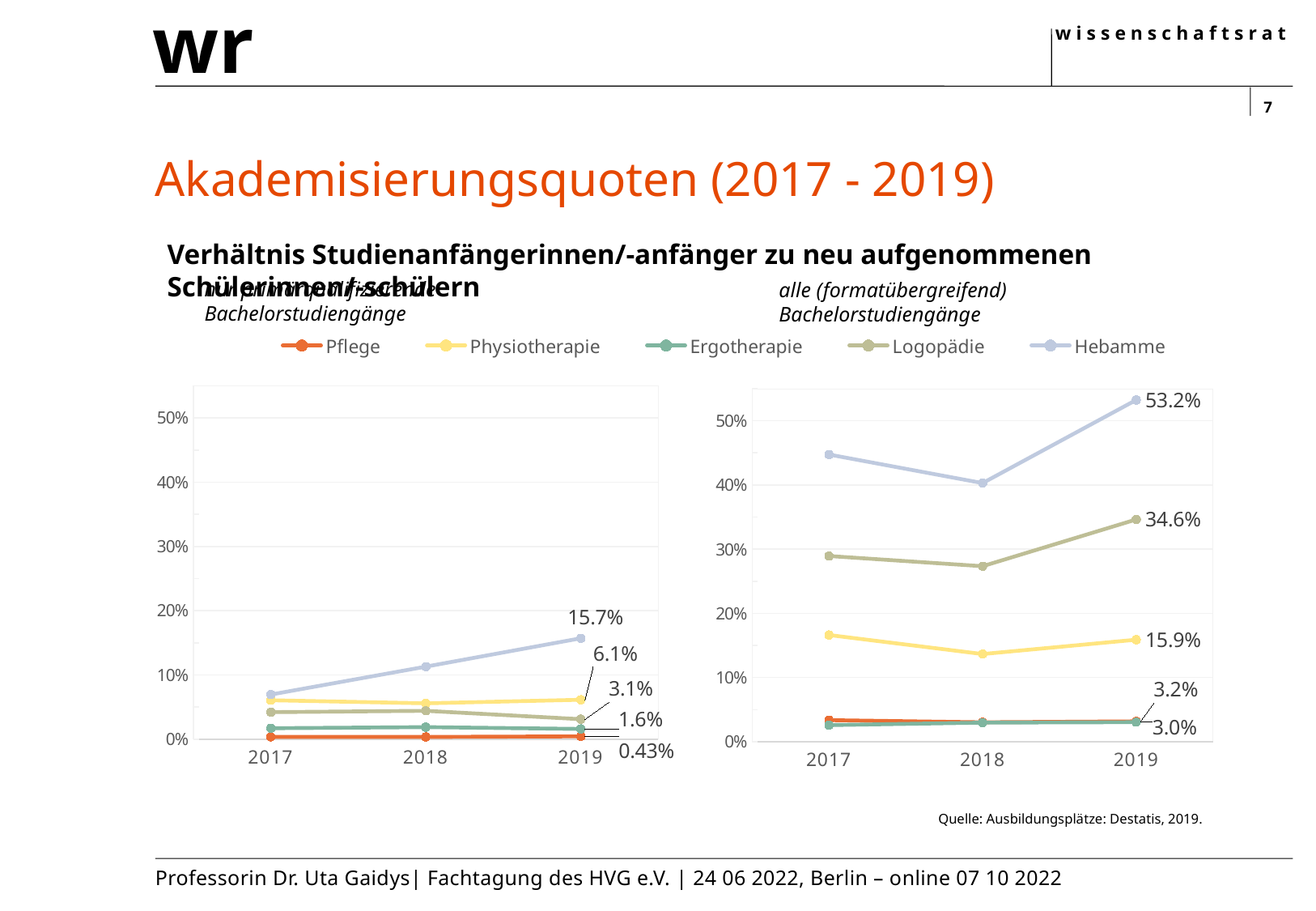
In the left chart, what is the value for Hebamme in 2019? 15.7% What kind of chart is the chart on the right? Line chart In the right chart (alle (formatübergreifend) Bachelorstudiengänge), is the value for Hebamme in 2018 greater or less than 50%? less How many series does the legend list for the charts? 5 In the left chart, what is the value for Physiotherapie in 2019? 6.1% In the left chart, what is the value for Pflege in 2019? 0.43% In the right chart (alle (formatübergreifend) Bachelorstudiengänge), what is the difference between the 2019 values for Hebamme and Logopädie? 18.6 percentage points In the right chart (alle (formatübergreifend) Bachelorstudiengänge), what is the value for Logopädie in 2019? 34.6% In the right chart (alle (formatübergreifend) Bachelorstudiengänge), which series has the highest value in 2019? Hebamme In the left chart, does the Hebamme line rise or fall from 2017 to 2019? Rises In the right chart (alle (formatübergreifend) Bachelorstudiengänge), what is the value for Hebamme in 2019? 53.2% In the left chart, which series has the lowest value in 2019? Pflege